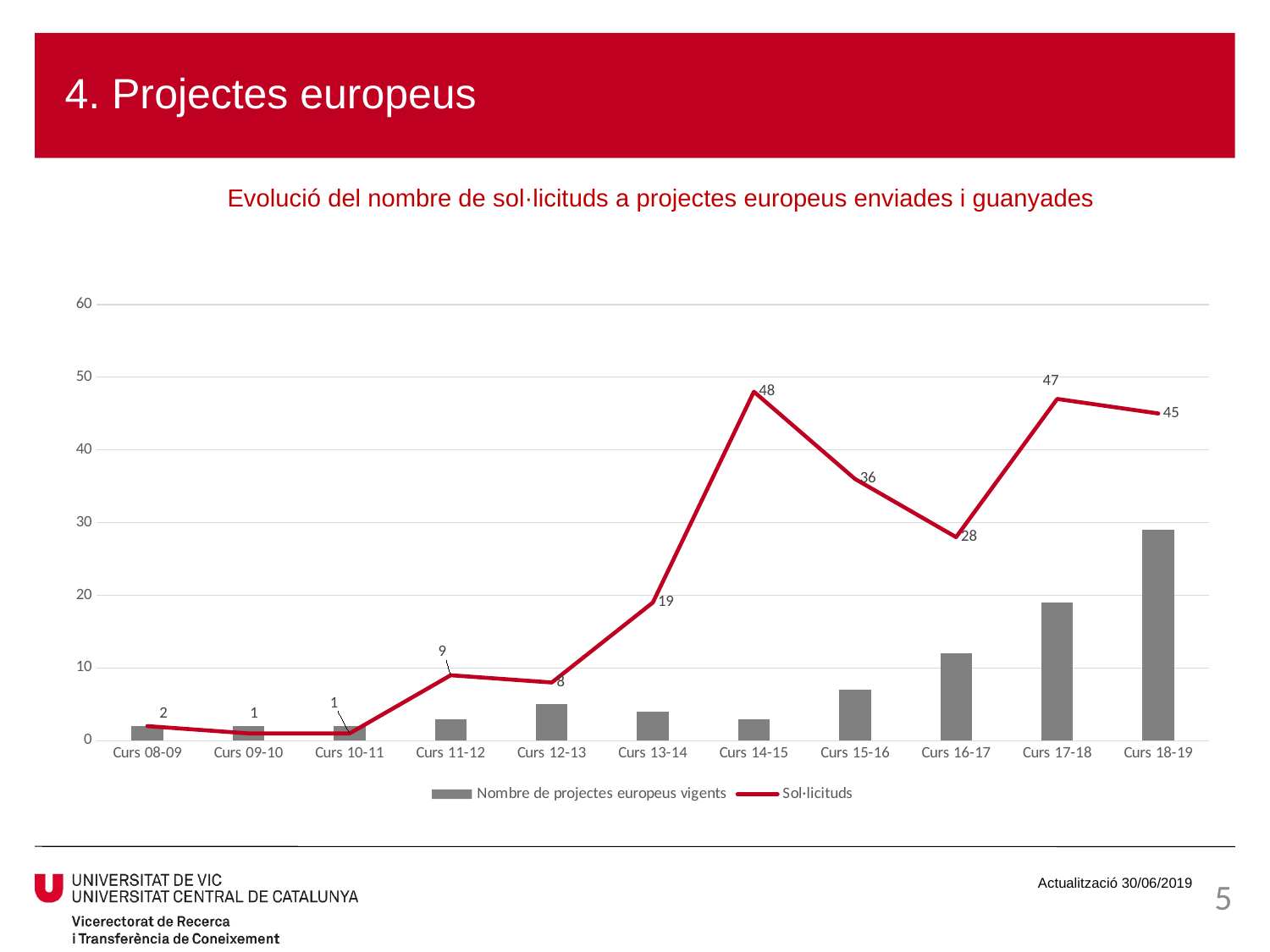
What kind of chart is shown on the slide? Combination bar and line chart In which academic year (Curs) is the number of Sol·licituds highest? Curs 14-15 Which has more Sol·licituds, Curs 15-16 or Curs 16-17? Curs 15-16 What is the value of Sol·licituds for Curs 17-18? 47 How many series does the legend list? 2 What is the difference between the Sol·licituds values for Curs 14-15 and Curs 15-16? 12 Is the value of Nombre de projectes europeus vigents for Curs 18-19 greater or less than 20? greater What is the value of Sol·licituds for Curs 11-12? 9 What is the value of Sol·licituds for Curs 14-15? 48 Do the Sol·licituds values rise or fall from Curs 10-11 to Curs 14-15? rise Is the value of Nombre de projectes europeus vigents for Curs 15-16 greater or less than 10? less How many academic years (Curs) are shown on the x axis? 11